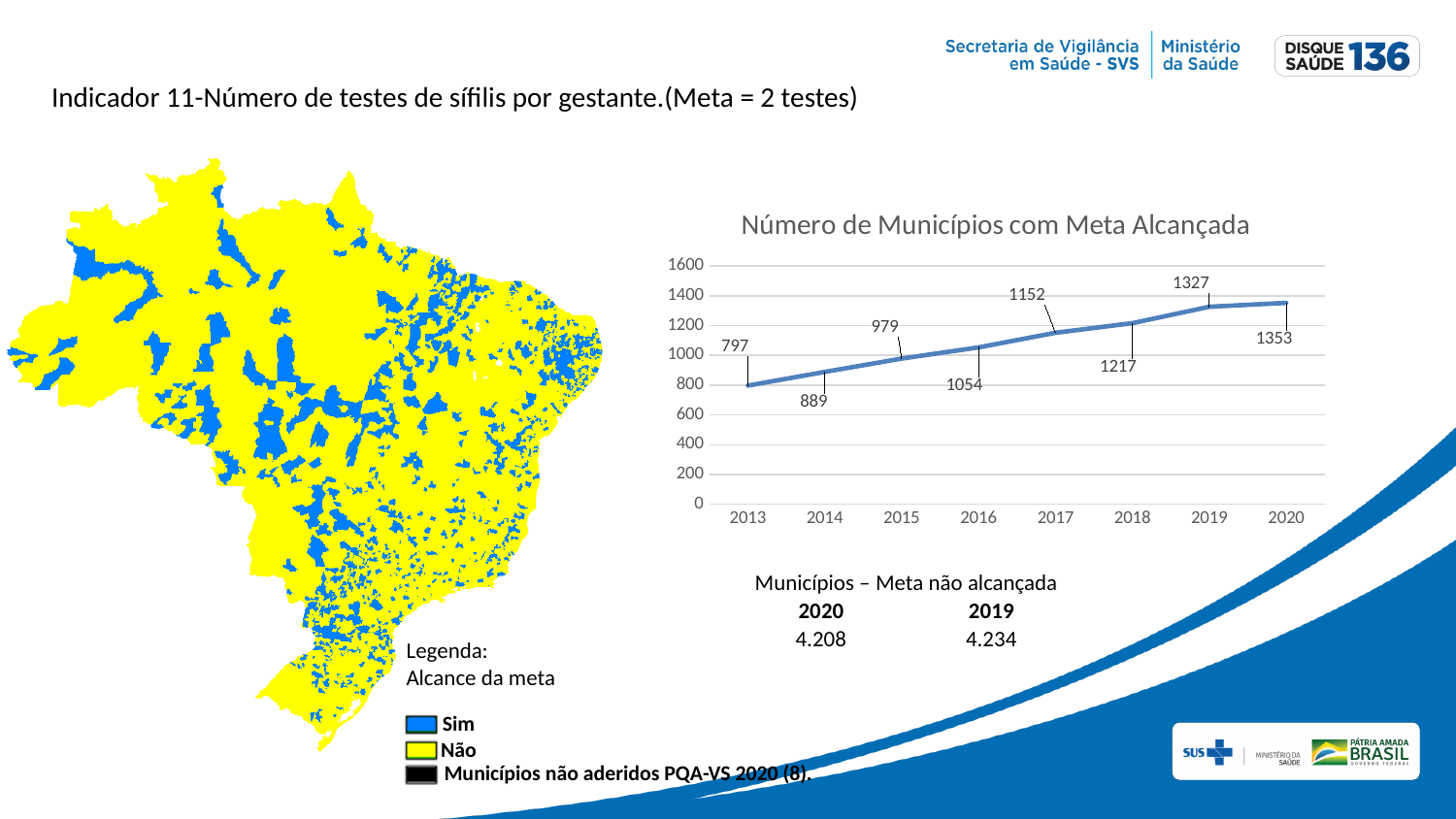
In the chart "Número de Municípios com Meta Alcançada", what is the difference between the values for 2020 and 2013? 556 In the chart "Número de Municípios com Meta Alcançada", what is the difference between the values for 2019 and 2018? 110 In the chart "Número de Municípios com Meta Alcançada", which year has the highest value? 2020 In the chart "Número de Municípios com Meta Alcançada", do the values rise or fall from 2013 to 2020? Rise In the chart "Número de Municípios com Meta Alcançada", what is the value for 2020? 1353 In the chart "Número de Municípios com Meta Alcançada", what is the value for 2017? 1152 How many years are plotted in the chart "Número de Municípios com Meta Alcançada"? 8 What type of chart is "Número de Municípios com Meta Alcançada"? Line chart In the chart "Número de Municípios com Meta Alcançada", which year has the lowest value? 2013 In the chart "Número de Municípios com Meta Alcançada", which is larger, the value for 2015 or the value for 2016? 2016 In the chart "Número de Municípios com Meta Alcançada", what is the value for 2013? 797 In the chart "Número de Municípios com Meta Alcançada", is the value for 2014 greater or less than 1000? less